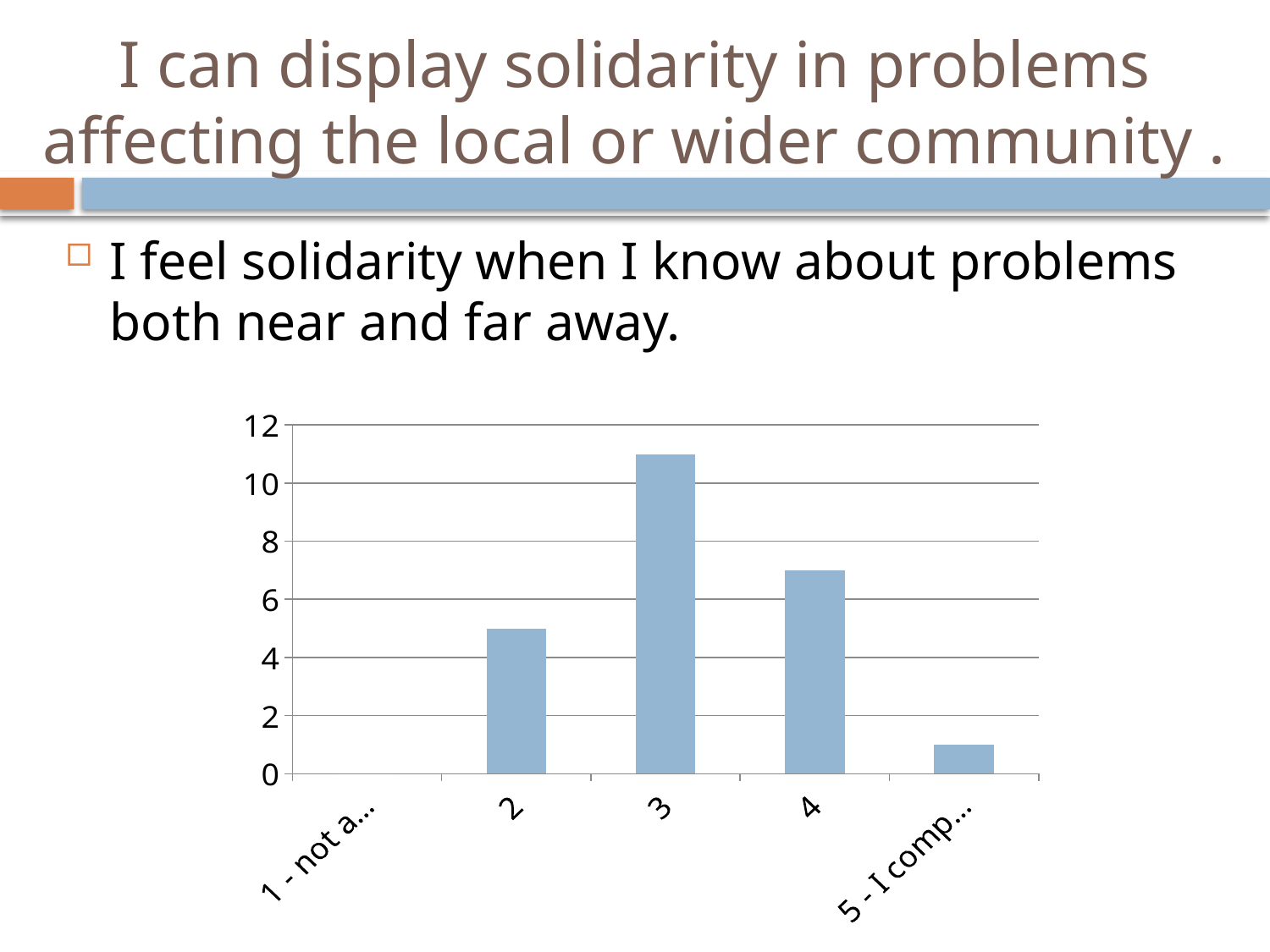
What kind of chart is shown on the slide? bar chart Is the value for category 4 greater or less than 8? less Is the value for the category labelled '5 - I comp...' greater or less than 2? less Among the categories 2, 3, 4 and 5, which has the lowest value? 5 - I comp... How many categories are shown on the x axis? 5 Which is larger, the value for category 2 or the value for category 4? 4 Which is larger, the value for category 3 or the value for category 4? 3 What is the highest value shown on the y axis? 12 Is the value for category 3 greater or less than 10? greater Which category has the highest bar? 3 Do the values rise or fall from category 3 to category 5? fall